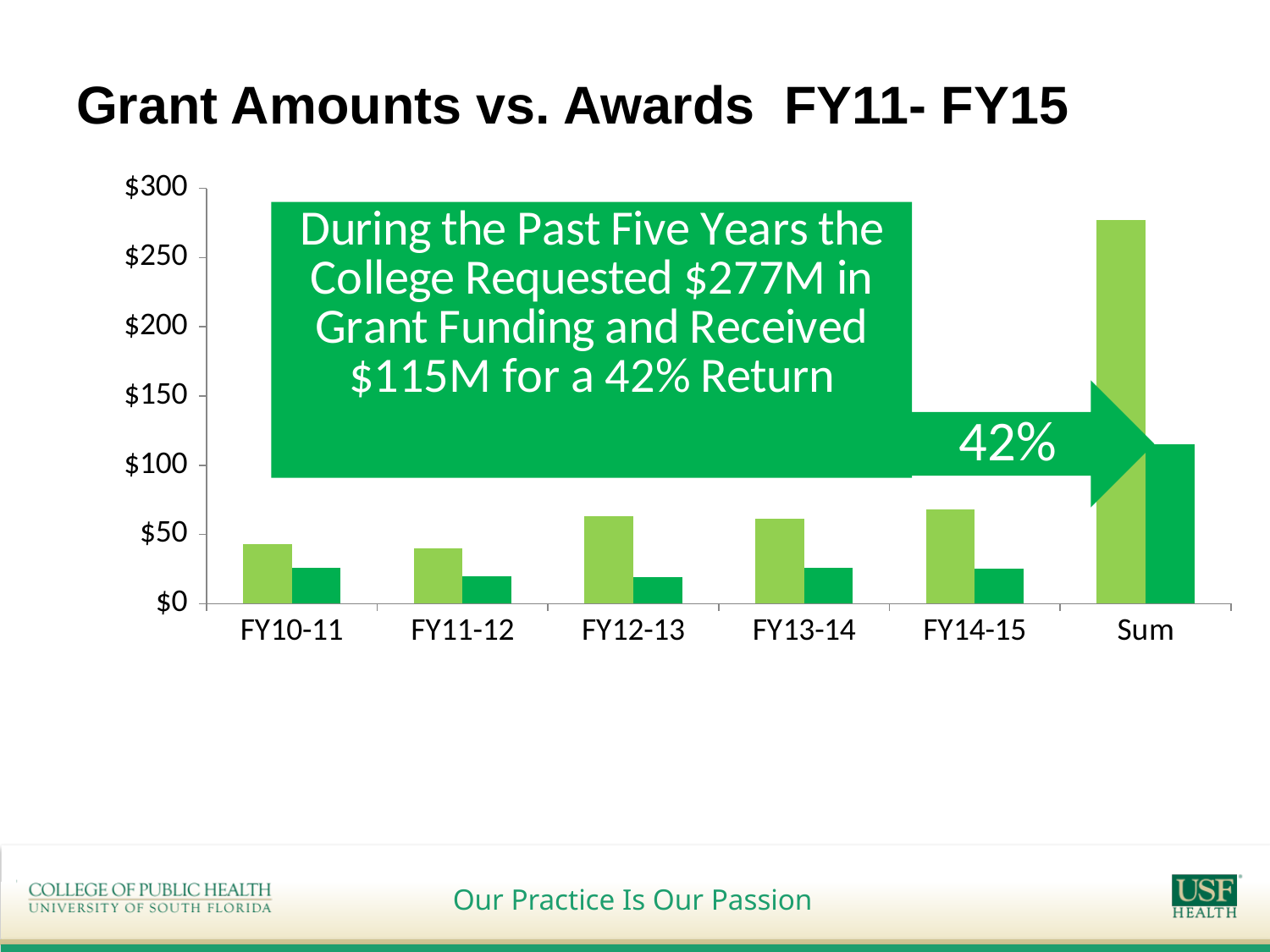
How many categories are shown on the x axis of the chart? 6 Which category on the x axis has the tallest bars? Sum For FY10-11, which bar is taller: the light green bar or the dark green bar? the light green bar Is the value of the dark green bar for Sum greater or less than $100? greater Is the value of the dark green bar for FY14-15 greater or less than $50? less According to the text on the chart, how much grant funding did the College request over the past five years? $277M Which is larger: the light green bar for FY12-13 or the light green bar for FY10-11? FY12-13 Is the value of the light green bar for Sum greater or less than $250? greater What percentage is shown in the arrow on the chart? 42% What kind of chart is shown on the slide? bar chart